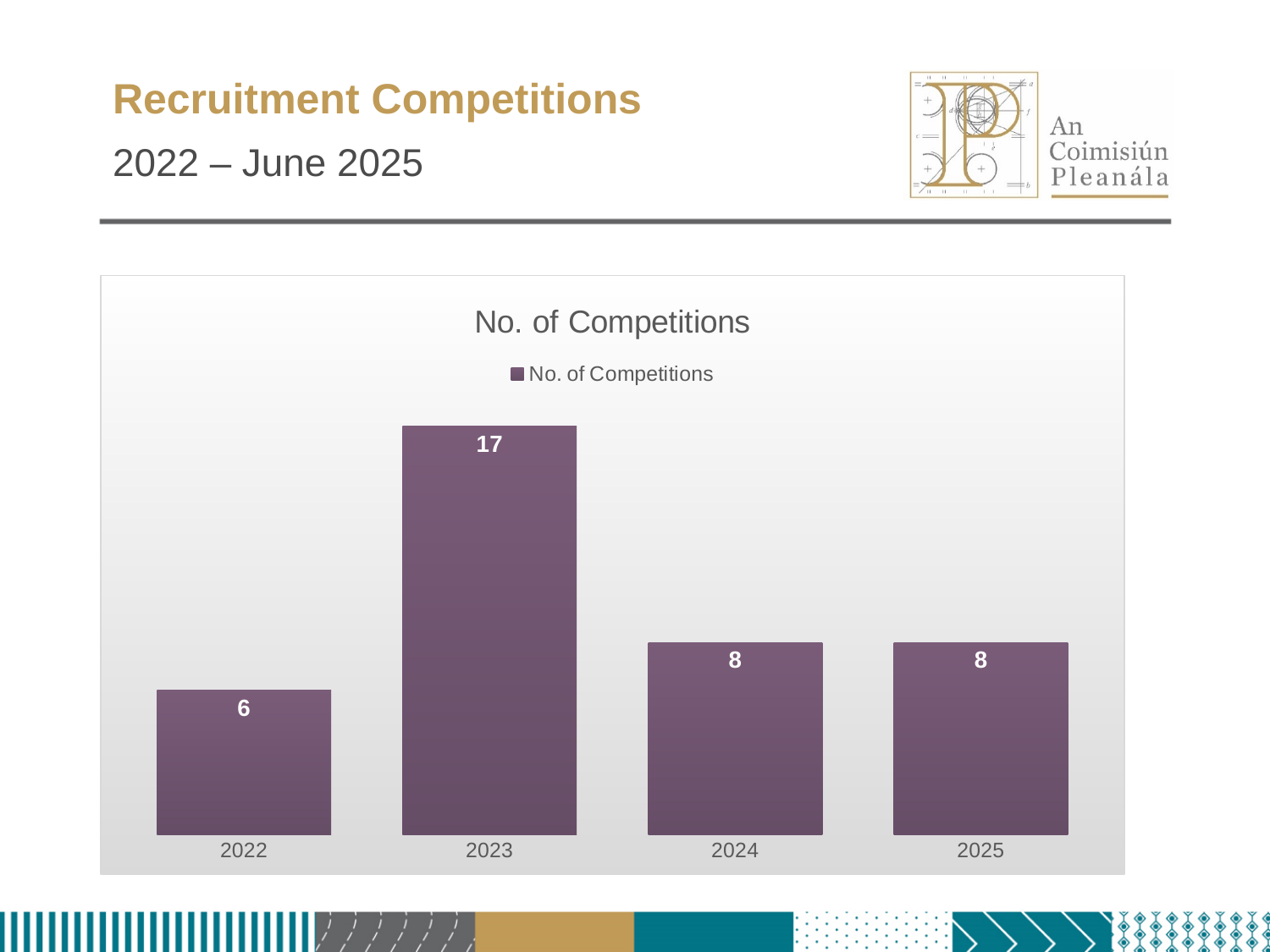
What is the difference between the number of competitions in 2024 and 2022? 2 What is the title of the chart? No. of Competitions What is the difference between the number of competitions in 2023 and 2022? 11 What is the number of competitions in 2024? 8 What is the number of competitions in 2022? 6 How many years are shown on the x axis of the chart? 4 What is the number of competitions in 2023? 17 Which year has the lowest number of competitions? 2022 Which year has the highest number of competitions? 2023 How many series does the legend list? 1 What kind of chart is shown on the slide? Bar chart Which year has more competitions, 2022 or 2025? 2025